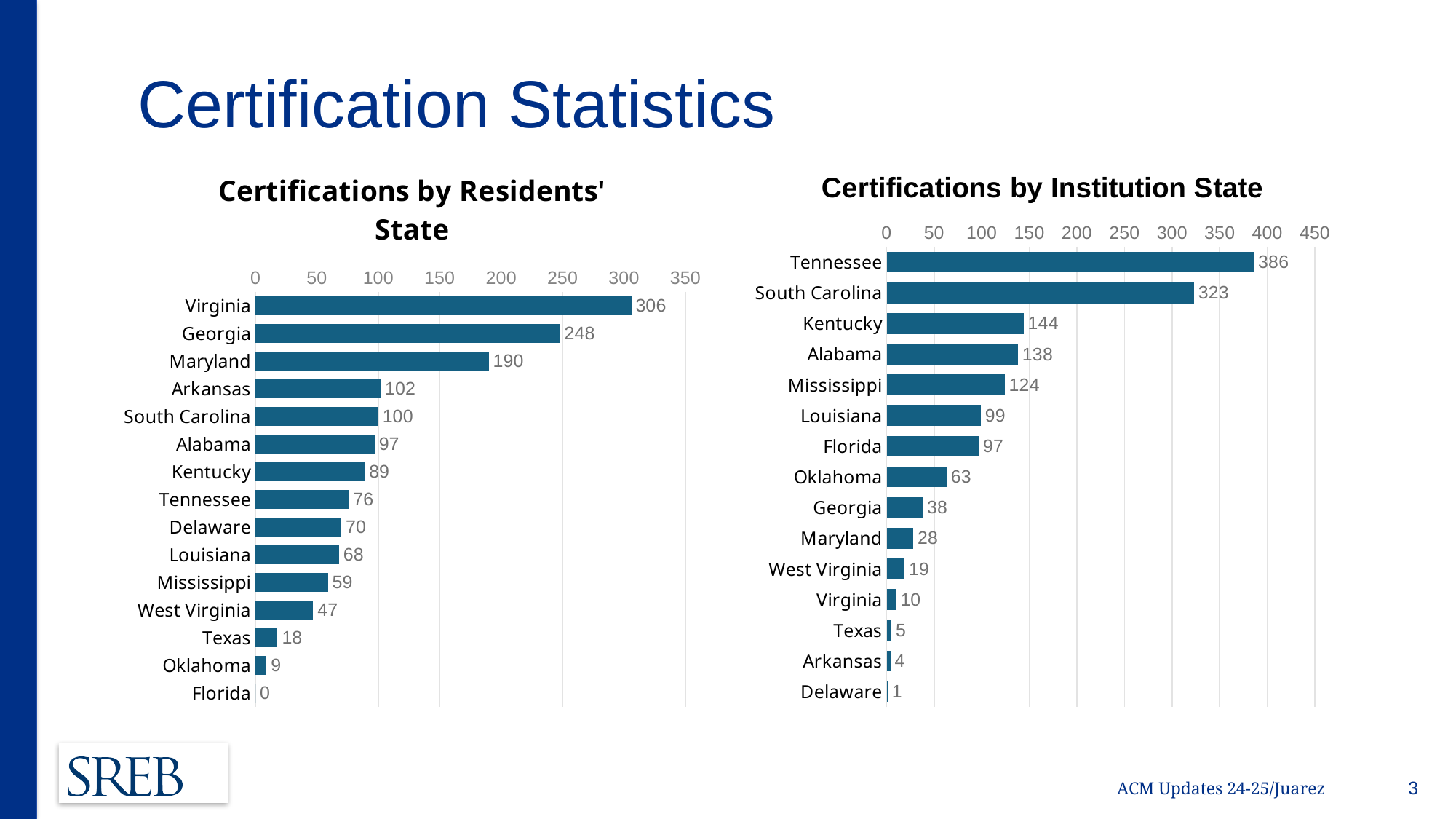
In the 'Certifications by Residents' State' chart, what is the difference between Georgia and Maryland? 58 In the 'Certifications by Residents' State' chart, which state has the lowest value? Florida In the 'Certifications by Institution State' chart, which state has the highest value? Tennessee In the 'Certifications by Residents' State' chart, what is the value for Virginia? 306 What kind of chart is 'Certifications by Residents' State'? Bar chart In the 'Certifications by Institution State' chart, what is the value for Delaware? 1 How many states are shown in the 'Certifications by Institution State' chart? 15 In the 'Certifications by Institution State' chart, which is larger, Louisiana or Oklahoma? Louisiana In the 'Certifications by Residents' State' chart, is the value for Arkansas greater or less than 100? greater In the 'Certifications by Institution State' chart, what is the value for Kentucky? 144 In the 'Certifications by Institution State' chart, what is the difference between Tennessee and South Carolina? 63 What is the title of the chart on the left side of the slide? Certifications by Residents' State